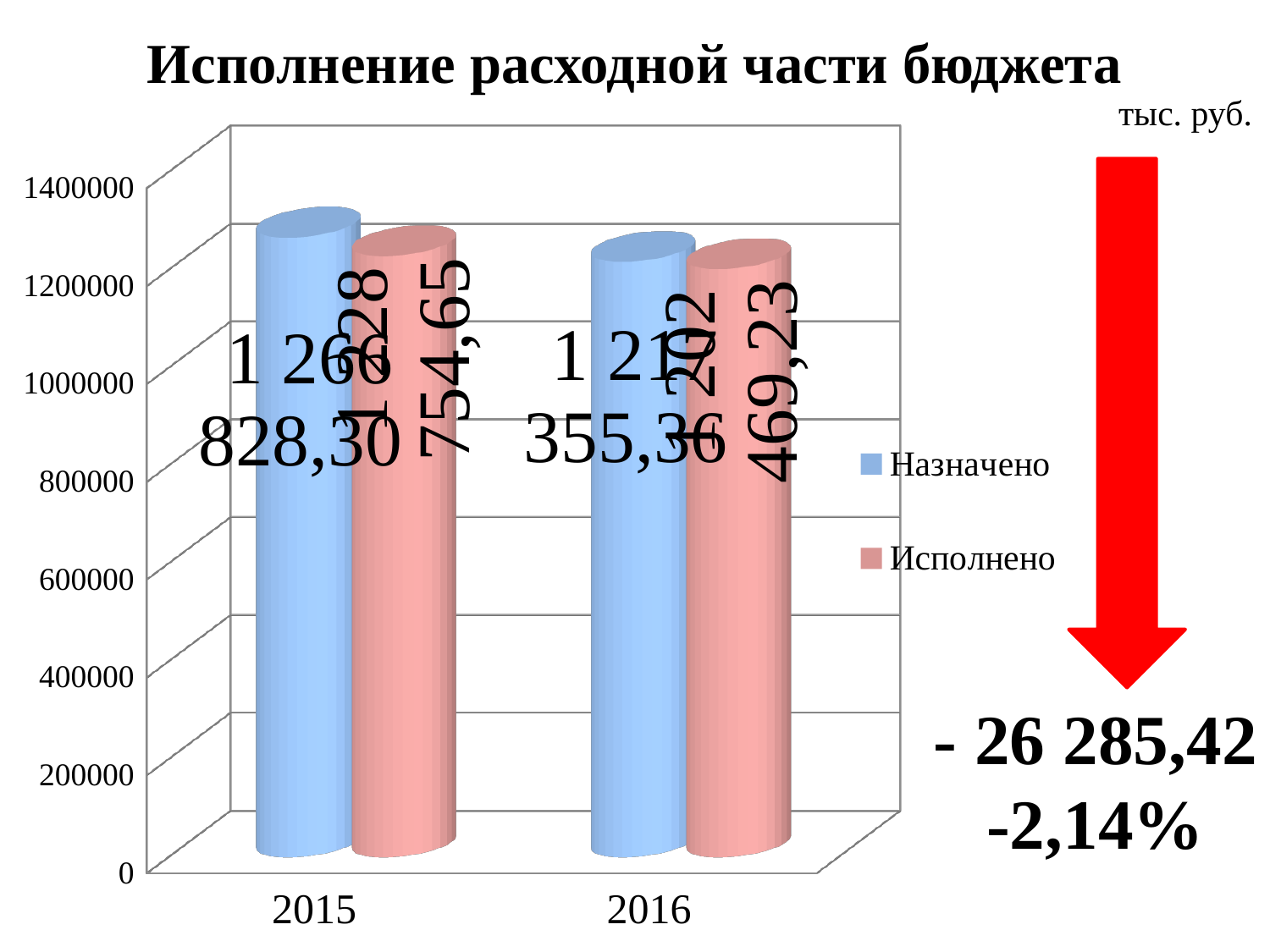
How many series does the legend list? 2 Does the Исполнено series rise or fall from 2015 to 2016? fall How many years (categories) are shown on the x axis? 2 Which bar is the tallest in the chart? Назначено for 2015 What is the title of the chart? Исполнение расходной части бюджета Does the Назначено series rise or fall from 2015 to 2016? fall For 2015, which is larger: Назначено or Исполнено? Назначено What is the value of Назначено for 2015? 1 266 828,30 What kind of chart is shown on the slide? bar chart Which series are listed in the legend? Назначено, Исполнено Is the value of Назначено for 2015 greater or less than 1200000? greater Is the value of Исполнено for 2016 greater or less than 1400000? less